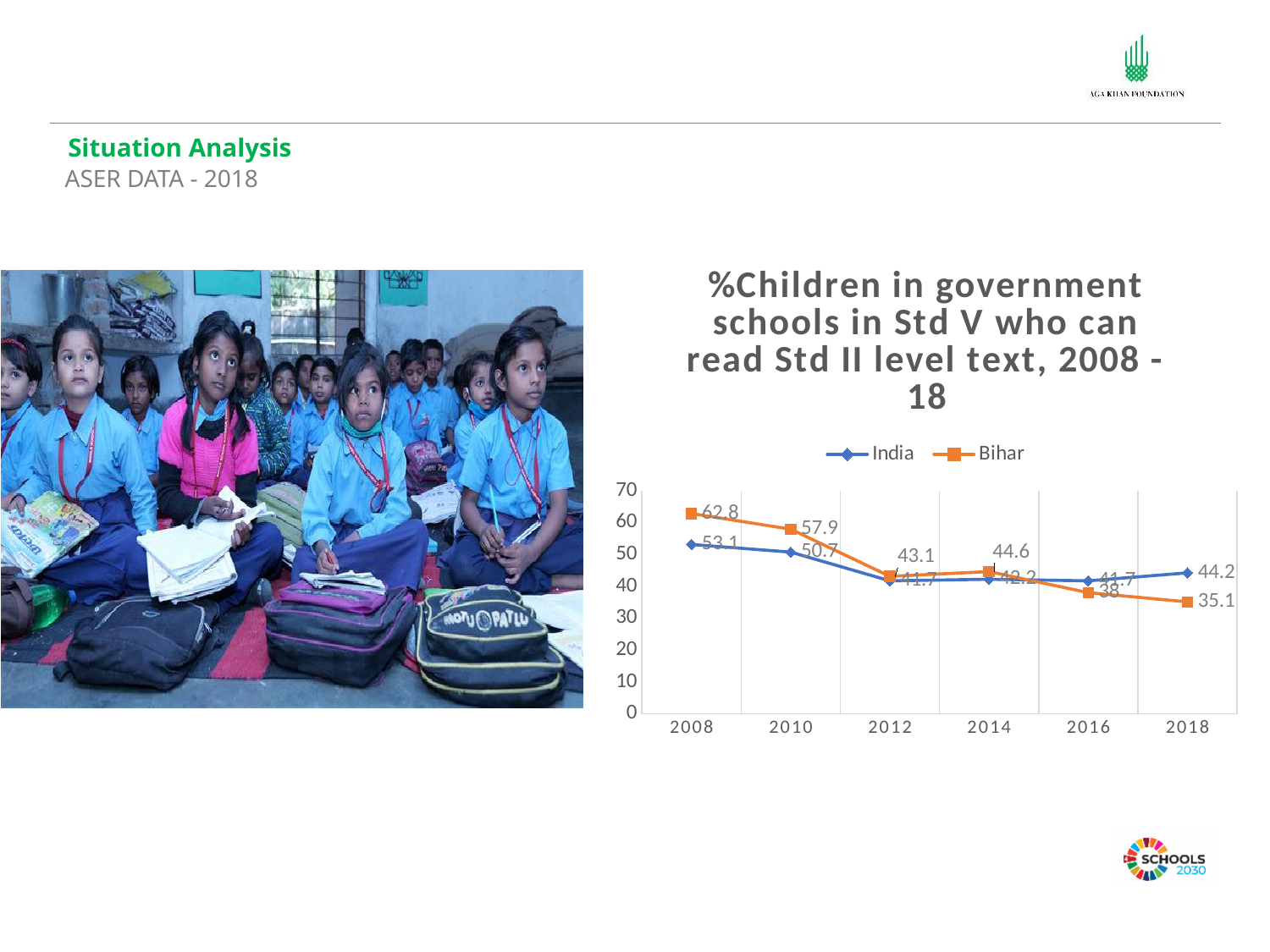
What is the value for Bihar in 2008? 62.8 In which year is the Bihar value highest? 2008 How many series does the legend of the chart list? 2 In 2008, which series has the larger value, India or Bihar? Bihar What is the value for Bihar in 2018? 35.1 Does the Bihar series generally rise or fall from 2008 to 2018? fall What is the value for India in 2018? 44.2 How many years are plotted along the x axis of the chart? 6 What is the value for India in 2010? 50.7 In which year is the Bihar value lowest? 2018 What is the difference between the Bihar values in 2008 and 2018? 27.7 What kind of chart is shown on the slide? line chart